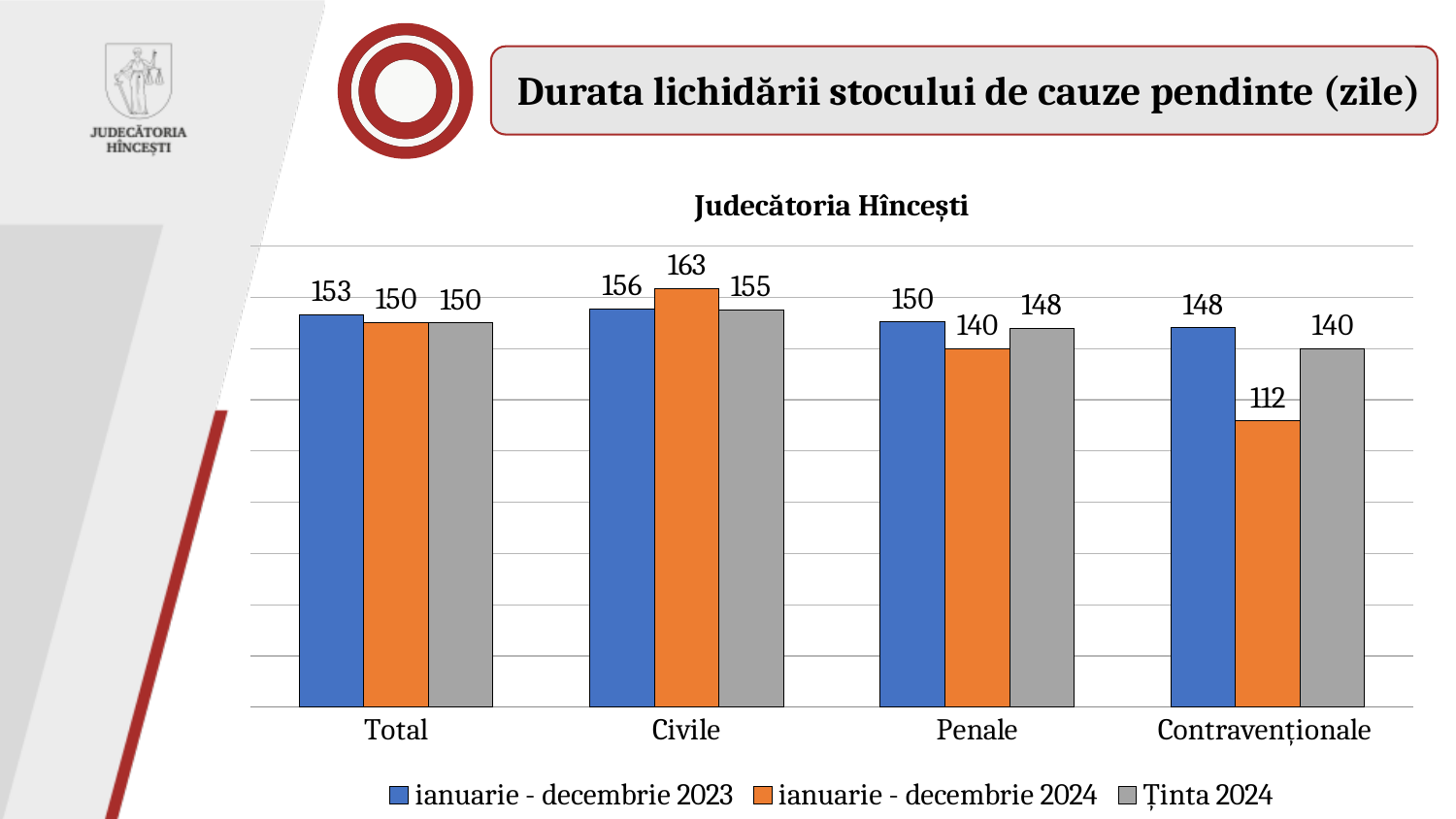
What is the value for Contravenționale in the 'ianuarie - decembrie 2023' series? 148 Which category has the lowest value in the 'ianuarie - decembrie 2024' series? Contravenționale Which is larger for Penale: the 'ianuarie - decembrie 2024' value or the 'Ținta 2024' value? Ținta 2024 How many categories are shown on the x axis? 4 What is the title of the chart? Judecătoria Hîncești What is the value for Civile in the 'ianuarie - decembrie 2024' series? 163 What is the difference between the 'ianuarie - decembrie 2024' value and the 'Ținta 2024' value for Civile? 8 How many series does the legend list? 3 What kind of chart is shown on the slide? Bar chart What is the 'Ținta 2024' value for Penale? 148 What is the difference between the 'ianuarie - decembrie 2023' and 'ianuarie - decembrie 2024' values for Contravenționale? 36 Which category has the highest value in the 'ianuarie - decembrie 2023' series? Civile